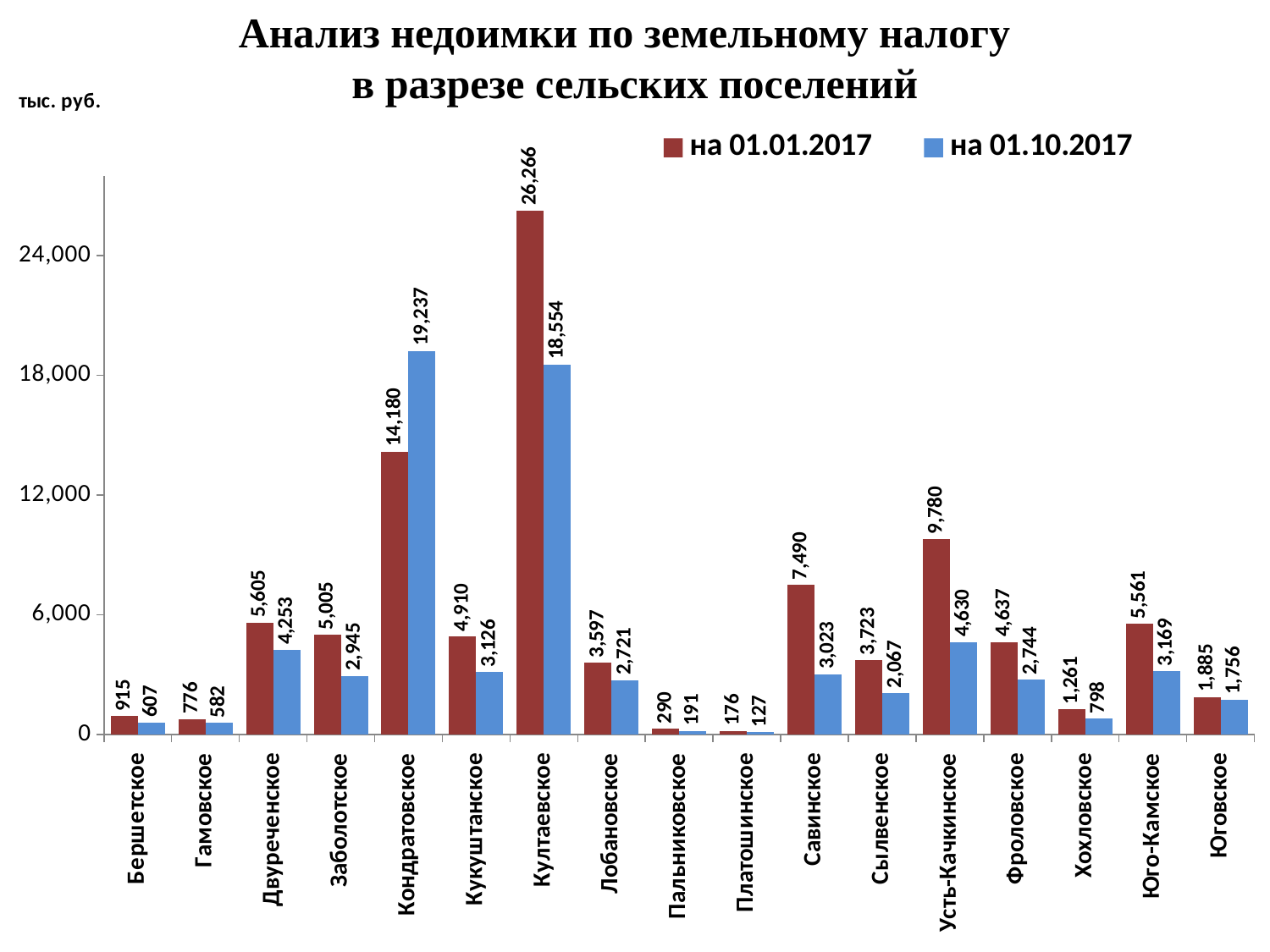
Which settlement has the lowest value in the series на 01.10.2017? Платошинское How many settlements are shown on the x axis? 17 What is the difference between the на 01.01.2017 and на 01.10.2017 values for Култаевское? 7,712 What kind of chart is shown on the slide? bar chart For Кондратовское, which series has the larger value: на 01.01.2017 or на 01.10.2017? на 01.10.2017 What is the difference between the на 01.01.2017 and на 01.10.2017 values for Савинское? 4,467 How many series does the legend list? 2 Is the value for Савинское in the series на 01.01.2017 greater or less than 6,000? greater Which settlement has the highest value in the series на 01.01.2017? Култаевское What is the value for Усть-Качкинское in the series на 01.01.2017? 9,780 In the series на 01.01.2017, which is larger: Усть-Качкинское or Савинское? Усть-Качкинское What is the value for Кондратовское in the series на 01.10.2017? 19,237